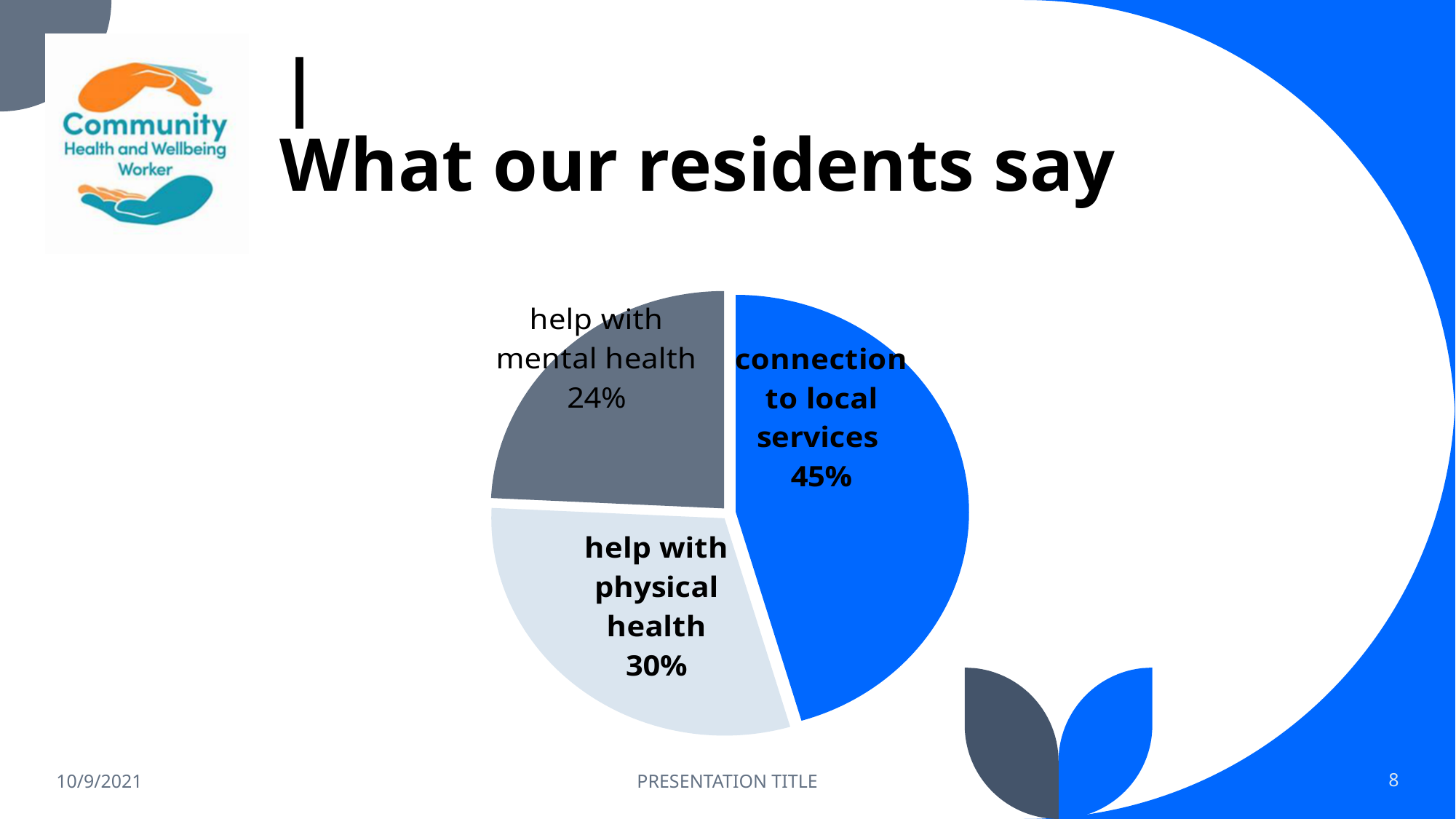
Which category has the largest share of the pie? connection to local services What percentage of residents said help with physical health? 30% What percentage of residents said connection to local services? 45% Which category has the smallest share of the pie? help with mental health How many categories are shown in the pie chart? 3 What is the difference in percentage points between help with physical health and help with mental health? 6 What is the difference in percentage points between connection to local services and help with mental health? 21 Which is larger: help with physical health or help with mental health? help with physical health What kind of chart is shown on the slide? pie chart What percentage of residents said help with mental health? 24% What is the title of the slide containing the pie chart? What our residents say What colour is the slice for connection to local services? blue